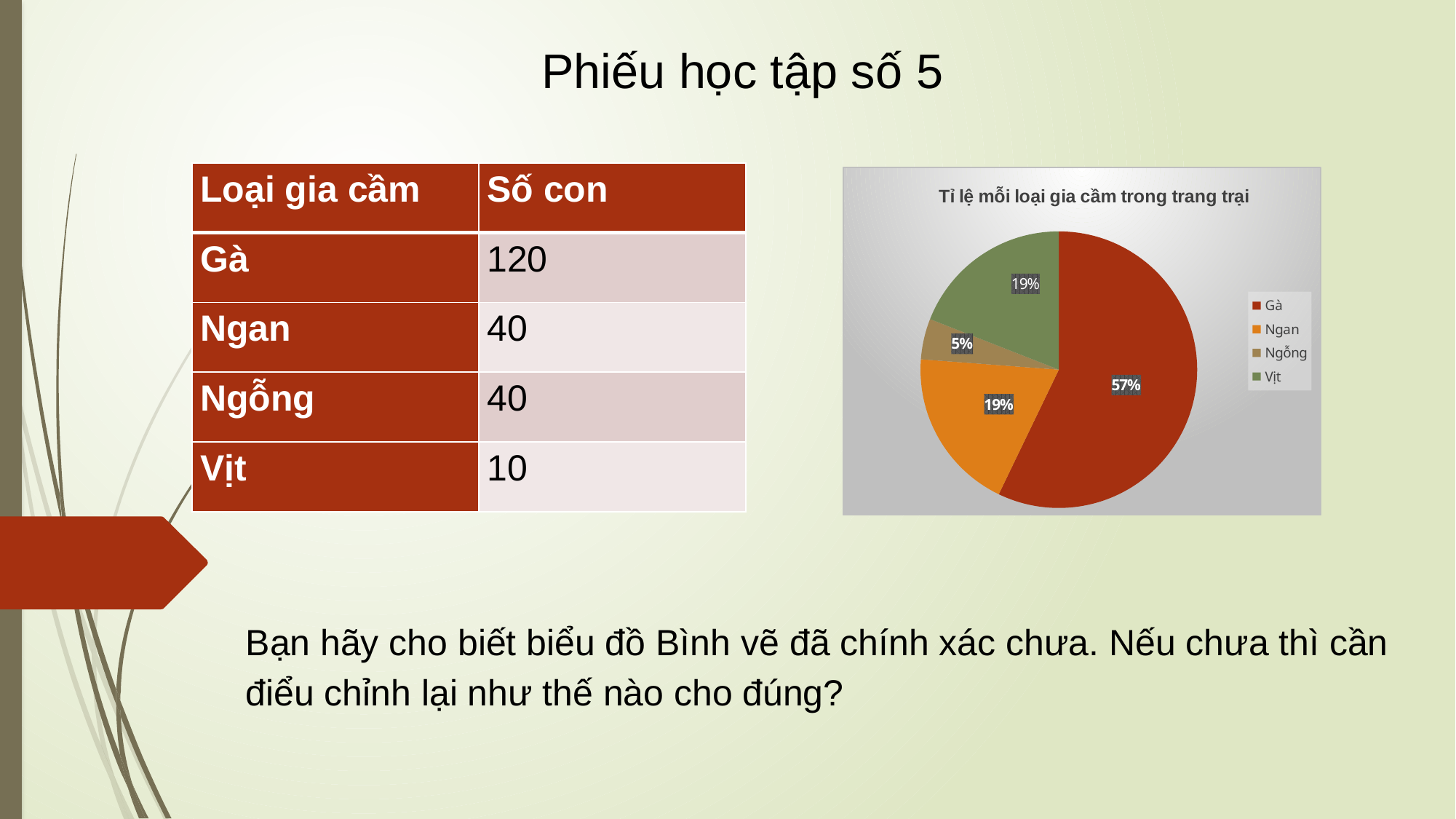
What percentage is shown for Ngỗng in the pie chart? 5% Which category has the largest slice in the pie chart? Gà How many entries does the pie chart's legend list? 4 What percentage is shown for Vịt in the pie chart? 19% What kind of chart is shown on the slide? pie chart What percentage is shown for Ngan in the pie chart? 19% In the pie chart, which is larger, the slice for Ngan or the slice for Ngỗng? Ngan In the pie chart, what is the difference between the percentages for Gà and Ngan? 38% What is the title of the pie chart? Tỉ lệ mỗi loại gia cầm trong trang trại How many slices does the pie chart have? 4 Which category has the smallest slice in the pie chart? Ngỗng What percentage is shown for Gà in the pie chart? 57%